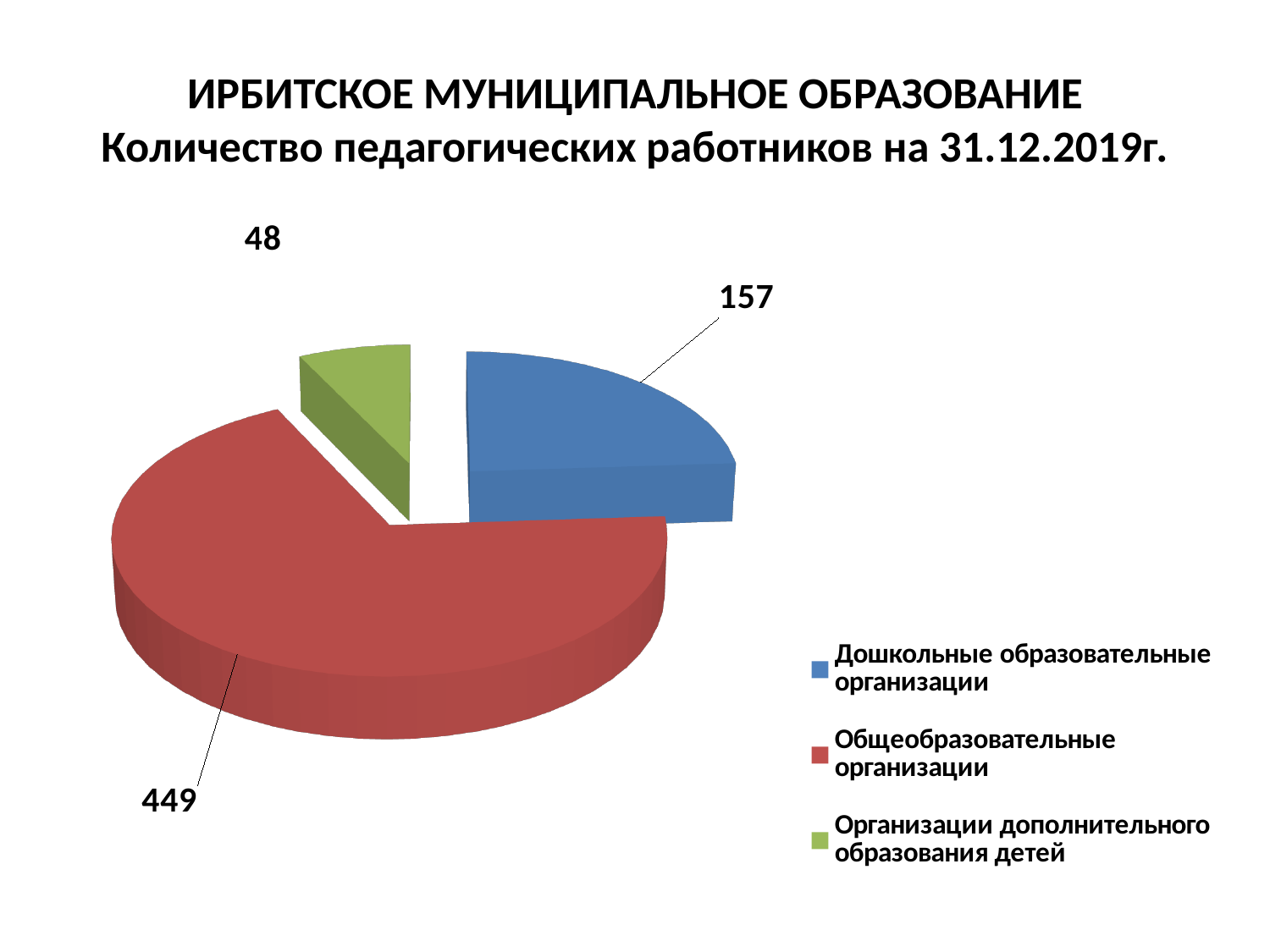
How many entries does the legend list? 3 What is the value for Организации дополнительного образования детей? 48 Which category has the smallest number of pedagogical workers? Организации дополнительного образования детей Which is larger: the value for Дошкольные образовательные организации or for Организации дополнительного образования детей? Дошкольные образовательные организации What kind of chart is shown on the slide? Pie chart What is the difference between the values for Общеобразовательные организации and Дошкольные образовательные организации? 292 What is the total of all three slices in the pie chart? 654 Which category has the largest number of pedagogical workers? Общеобразовательные организации What is the value for Дошкольные образовательные организации? 157 How many slices does the pie chart have? 3 What is the value for Общеобразовательные организации? 449 What colour is the slice for Общеобразовательные организации? Red